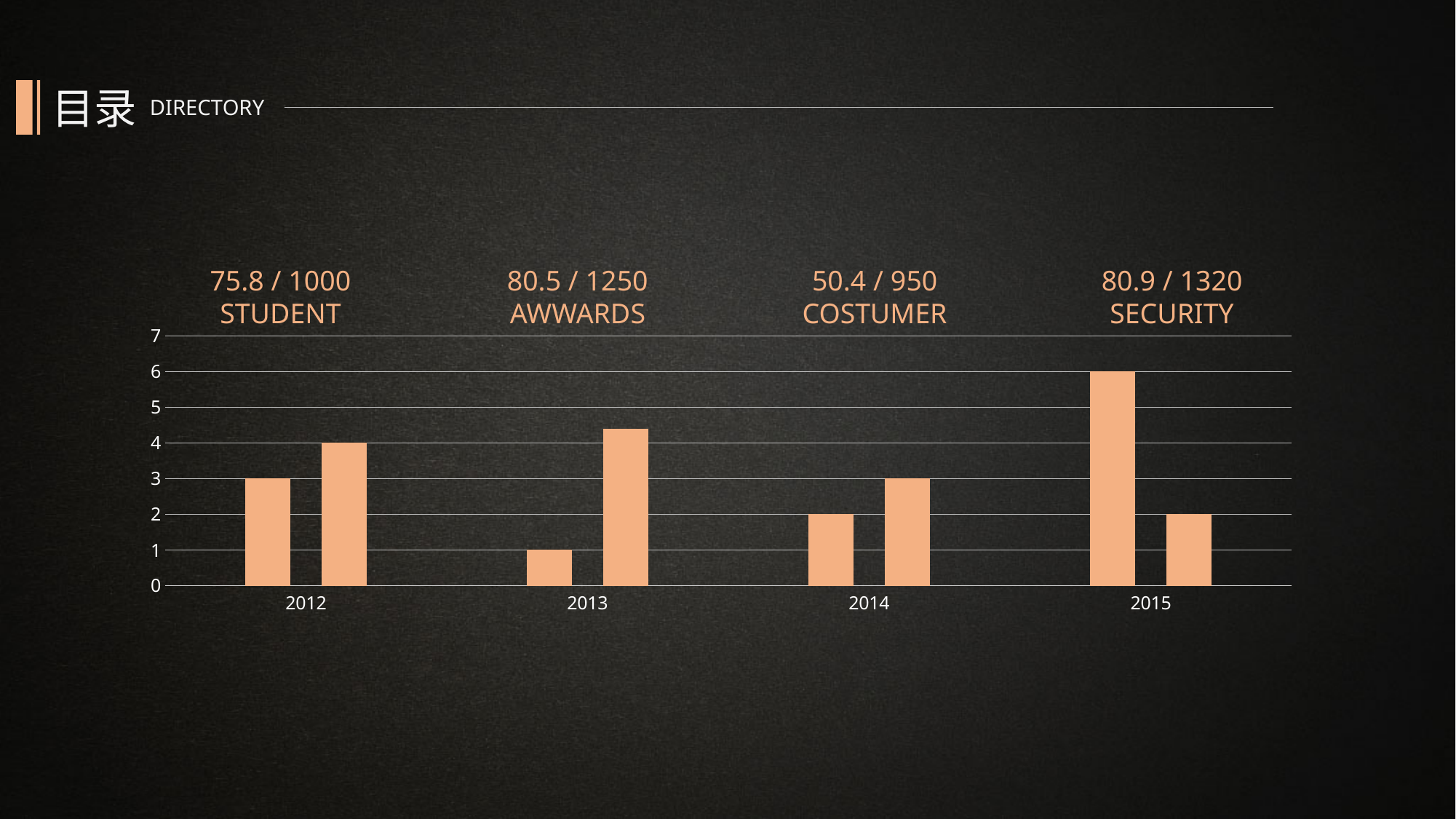
What is the value of the first (left) bar for 2013? 1 What is the value of the second (right) bar for 2012? 4 What label text appears above the 2015 group of bars? 80.9 / 1320 SECURITY Which year has the shortest bar in the chart? 2013 What is the value of the first (left) bar for 2015? 6 How many bars are plotted for each year? 2 How many years are shown on the x axis of the chart? 4 Is the value of the second (right) bar for 2013 greater or less than 4? greater Which year has the tallest bar in the chart? 2015 What kind of chart is shown on the slide? bar chart What is the difference between the first and second bars for 2015? 4 What is the value of the first (left) bar for 2012? 3